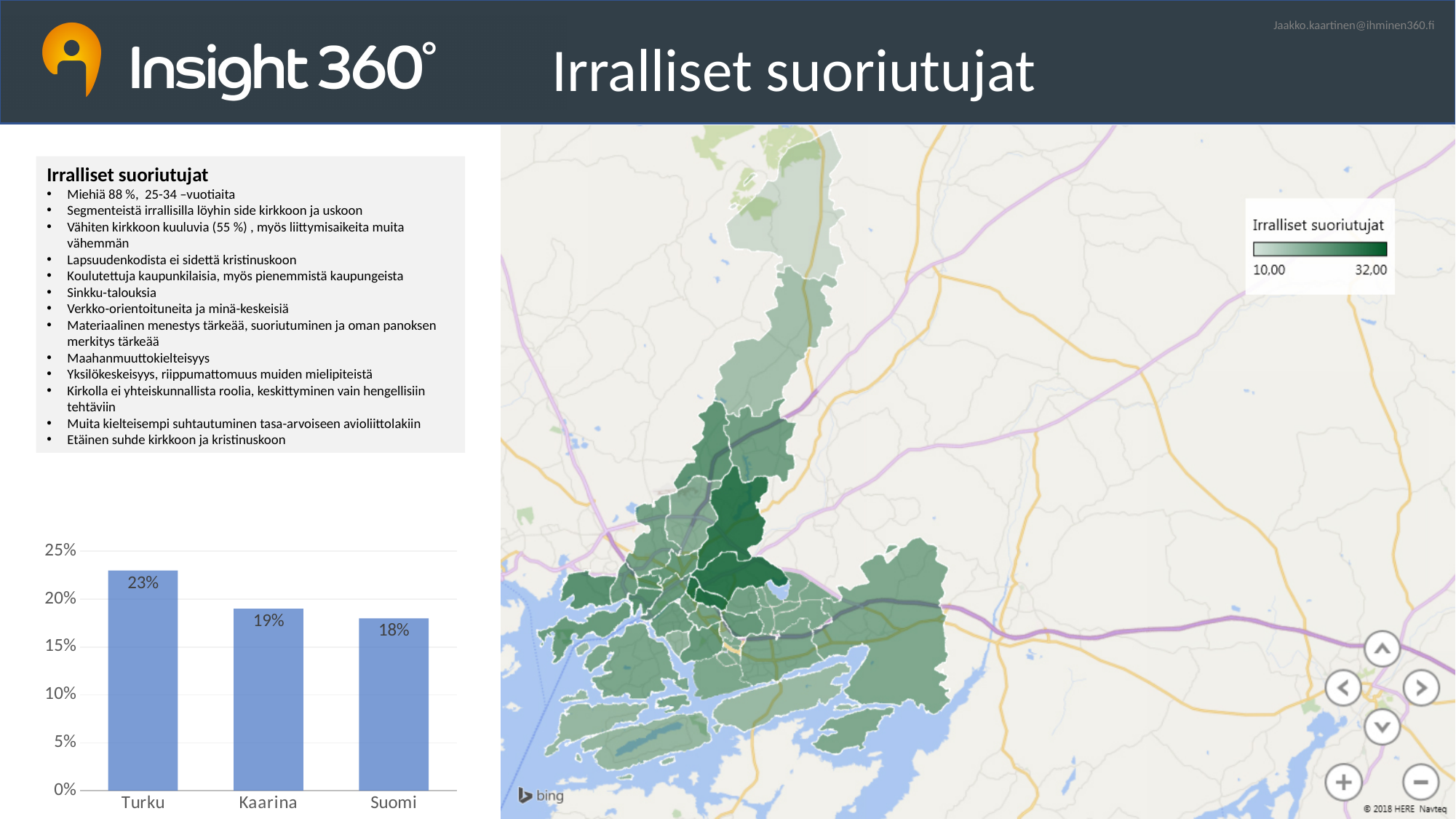
In the bar chart at the bottom left, how many categories are shown? 3 What kind of chart is shown at the bottom left of the slide? bar chart In the bar chart at the bottom left, what is the value for Kaarina? 19% In the bar chart at the bottom left, what is the difference between the values for Turku and Suomi? 5% In the bar chart at the bottom left, which category has the lowest value? Suomi In the bar chart at the bottom left, which category has the highest value? Turku In the bar chart at the bottom left, is the value for Turku greater or less than 20%? greater In the bar chart at the bottom left, what is the difference between the values for Turku and Kaarina? 4% In the bar chart at the bottom left, what is the value for Turku? 23% In the map chart on the right, what are the minimum and maximum values shown on the colour legend? 10,00 and 32,00 In the bar chart at the bottom left, what is the value for Suomi? 18% In the bar chart at the bottom left, which is larger, the value for Turku or the value for Kaarina? Turku